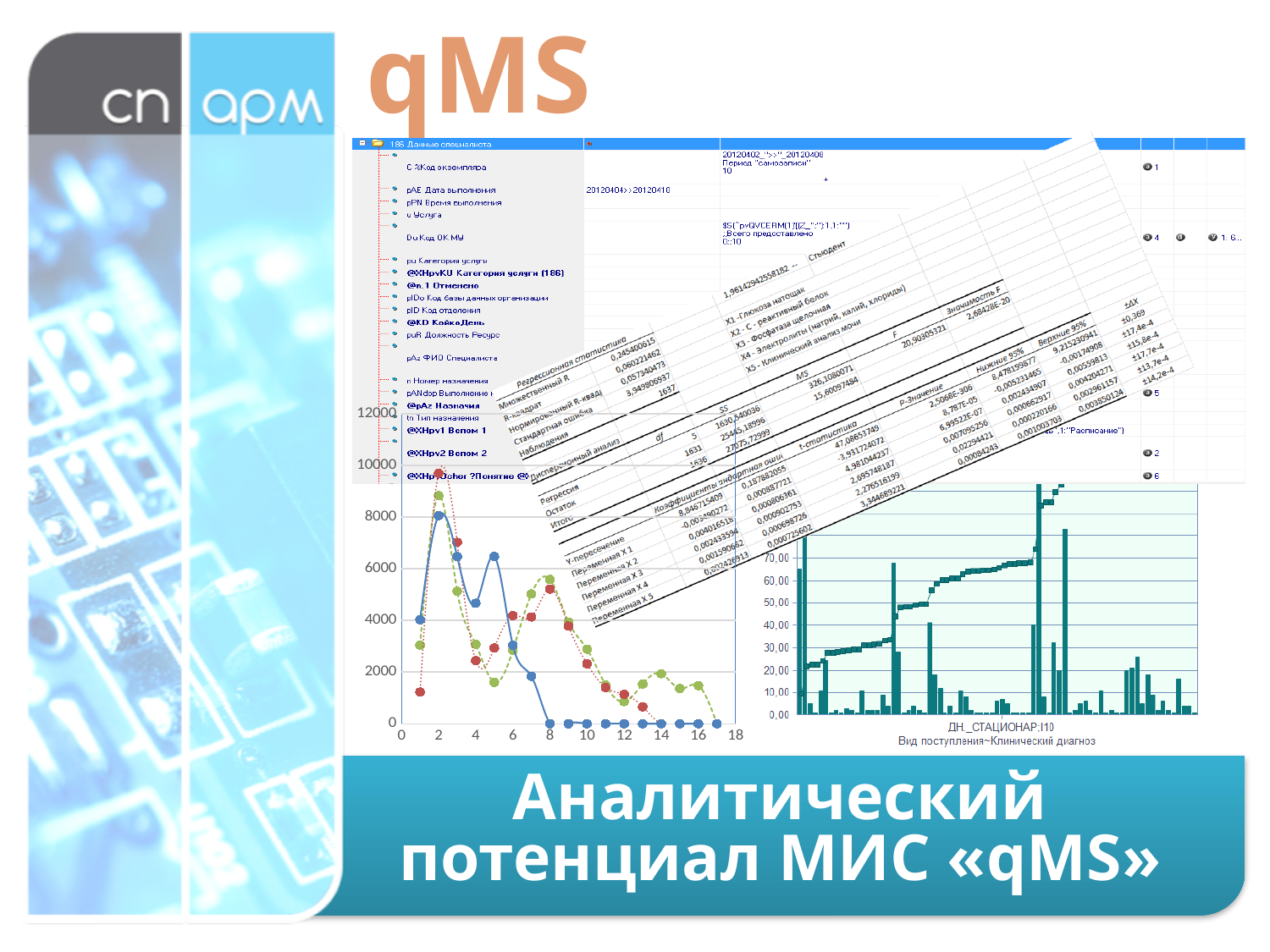
In the line chart in the lower left, is the value of the blue series at x = 2 greater or less than 6000? greater In the line chart in the lower left, what is the value of the blue series at x = 14? 0 In the line chart in the lower left, does the blue series rise or fall between x = 2 and x = 4? fall In the line chart in the lower left, is the value of the green series at x = 8 greater or less than 4000? greater In the line chart in the lower left, is the value of the blue series at x = 7 greater or less than 4000? less What is the x-axis label of the bar chart in the lower right of the slide? Вид поступления~Клинический диагноз In the line chart in the lower left, how many series are plotted? 3 What kind of chart is the chart in the lower right of the slide, labelled ДН_СТАЦИОНАР:I10? bar chart In the line chart in the lower left, what is the value of the blue series at x = 10? 0 What kind of chart is the chart in the lower left of the slide, with the x axis running from 0 to 18? line chart